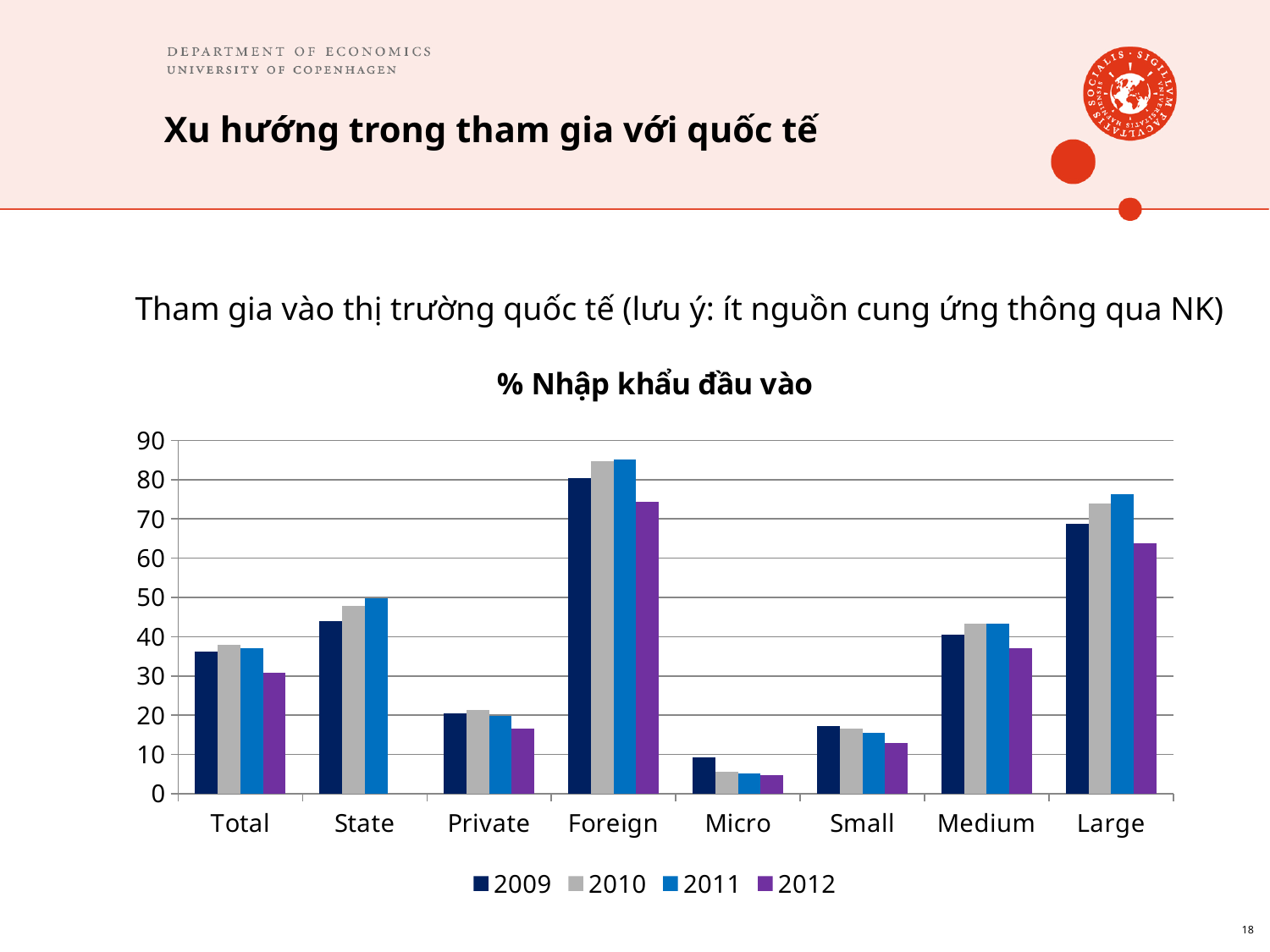
How many series does the legend list? 4 Do the values for Micro rise or fall from 2009 to 2012? fall Which category has the highest value for 2011? Foreign Is the value for Foreign in 2010 greater or less than 80? greater Which is larger for 2011: Large or Medium? Large Which is larger for 2012: Foreign or Large? Foreign How many categories are shown on the x axis? 8 Is the value for Large in 2009 greater or less than 60? greater What kind of chart is shown on the slide? bar chart What is the title of the chart? % Nhập khẩu đầu vào Is the value for Micro in 2009 greater or less than 10? less Which category has the lowest value for 2009? Micro